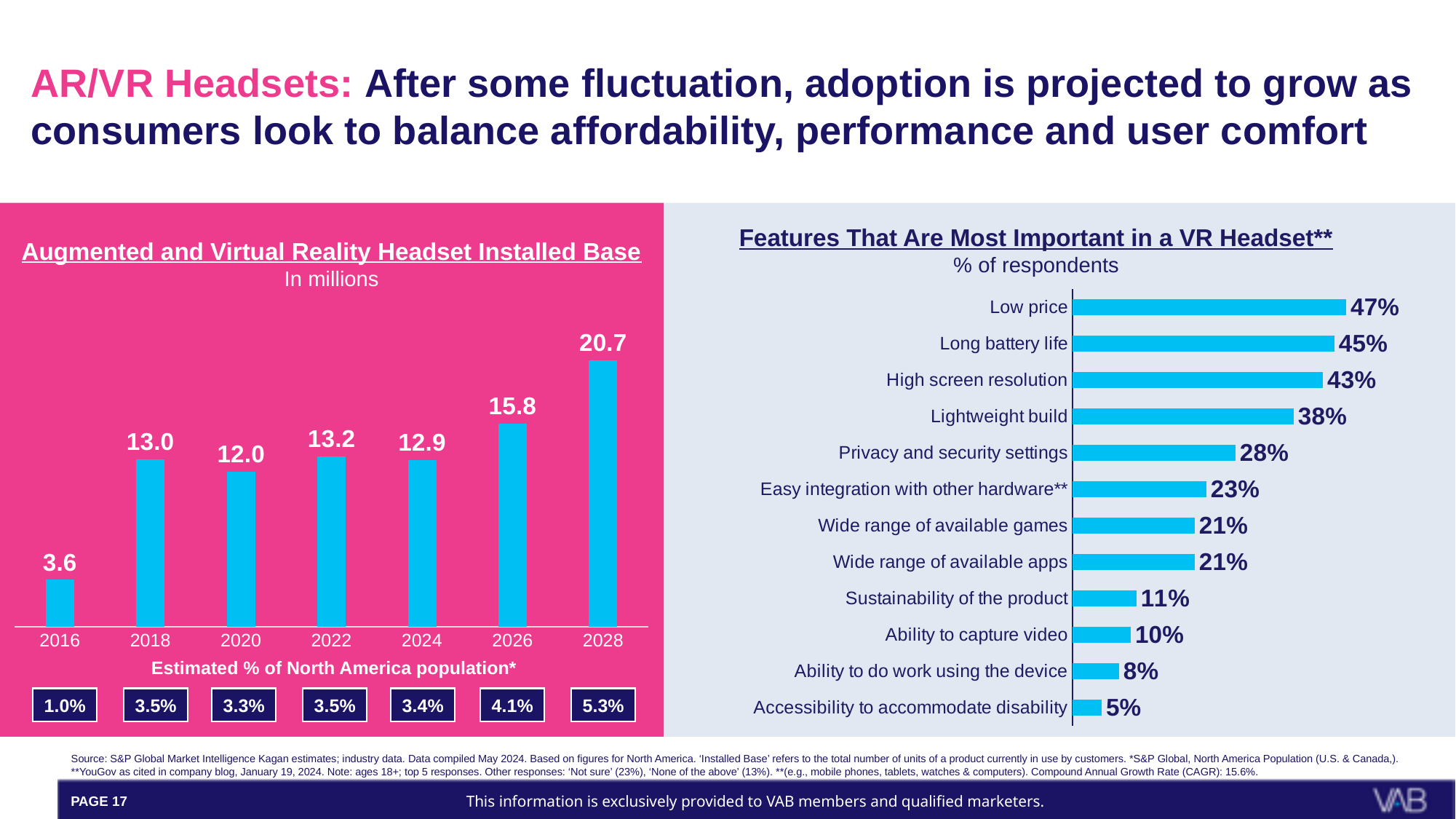
In the 'Augmented and Virtual Reality Headset Installed Base' chart, which year has the lowest installed base? 2016 In the 'Features That Are Most Important in a VR Headset' chart, what percentage of respondents chose 'Lightweight build'? 38% In the 'Features That Are Most Important in a VR Headset' chart, what is the difference between 'Low price' and 'Privacy and security settings'? 19% How many years are shown in the 'Augmented and Virtual Reality Headset Installed Base' chart? 7 How many features are listed in the 'Features That Are Most Important in a VR Headset' chart? 12 What kind of chart is the 'Augmented and Virtual Reality Headset Installed Base' chart? Bar chart In the 'Augmented and Virtual Reality Headset Installed Base' chart, which is larger, the value for 2022 or the value for 2024? 2022 In the 'Features That Are Most Important in a VR Headset' chart, which feature has the highest percentage? Low price In the 'Augmented and Virtual Reality Headset Installed Base' chart, what is the difference between the 2028 and 2026 values? 4.9 In the 'Features That Are Most Important in a VR Headset' chart, which feature has the lowest percentage? Accessibility to accommodate disability In the 'Augmented and Virtual Reality Headset Installed Base' chart, what is the estimated % of North America population shown for 2028? 5.3% In the 'Augmented and Virtual Reality Headset Installed Base' chart, what is the value for 2028? 20.7